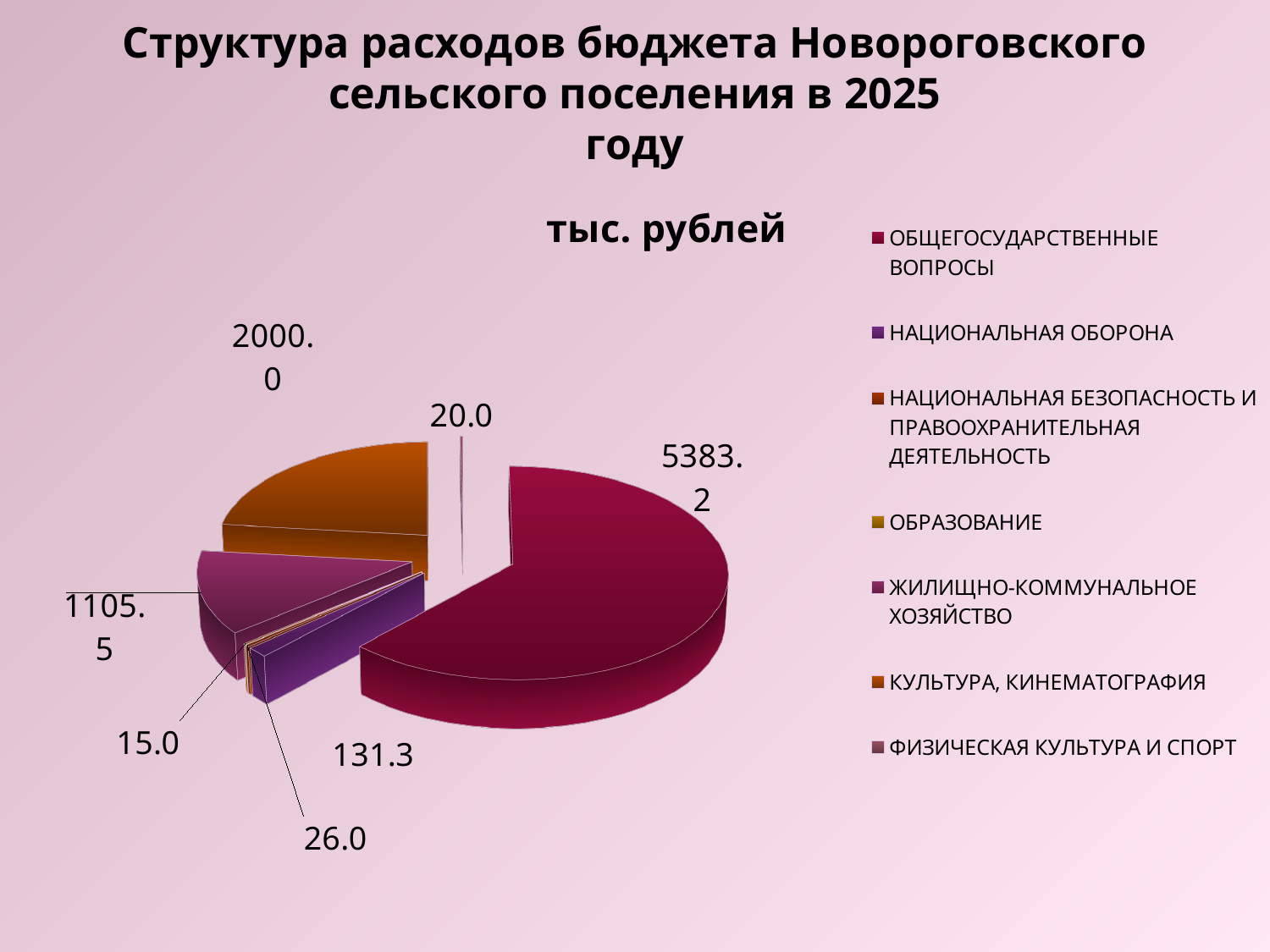
What is the difference between the values for ОБЩЕГОСУДАРСТВЕННЫЕ ВОПРОСЫ and КУЛЬТУРА, КИНЕМАТОГРАФИЯ? 3383.2 Which category has the largest slice of the pie? ОБЩЕГОСУДАРСТВЕННЫЕ ВОПРОСЫ What is the value for ЖИЛИЩНО-КОММУНАЛЬНОЕ ХОЗЯЙСТВО? 1105.5 What is the title shown above the pie chart? тыс. рублей How many entries does the legend list? 7 What is the smallest value labelled on the pie chart? 15.0 What is the value for КУЛЬТУРА, КИНЕМАТОГРАФИЯ? 2000.0 What is the value for ОБЩЕГОСУДАРСТВЕННЫЕ ВОПРОСЫ? 5383.2 Which is larger: ЖИЛИЩНО-КОММУНАЛЬНОЕ ХОЗЯЙСТВО or КУЛЬТУРА, КИНЕМАТОГРАФИЯ? КУЛЬТУРА, КИНЕМАТОГРАФИЯ What kind of chart is shown on the slide? pie chart How many slices does the pie chart have? 7 What is the value for НАЦИОНАЛЬНАЯ ОБОРОНА? 131.3